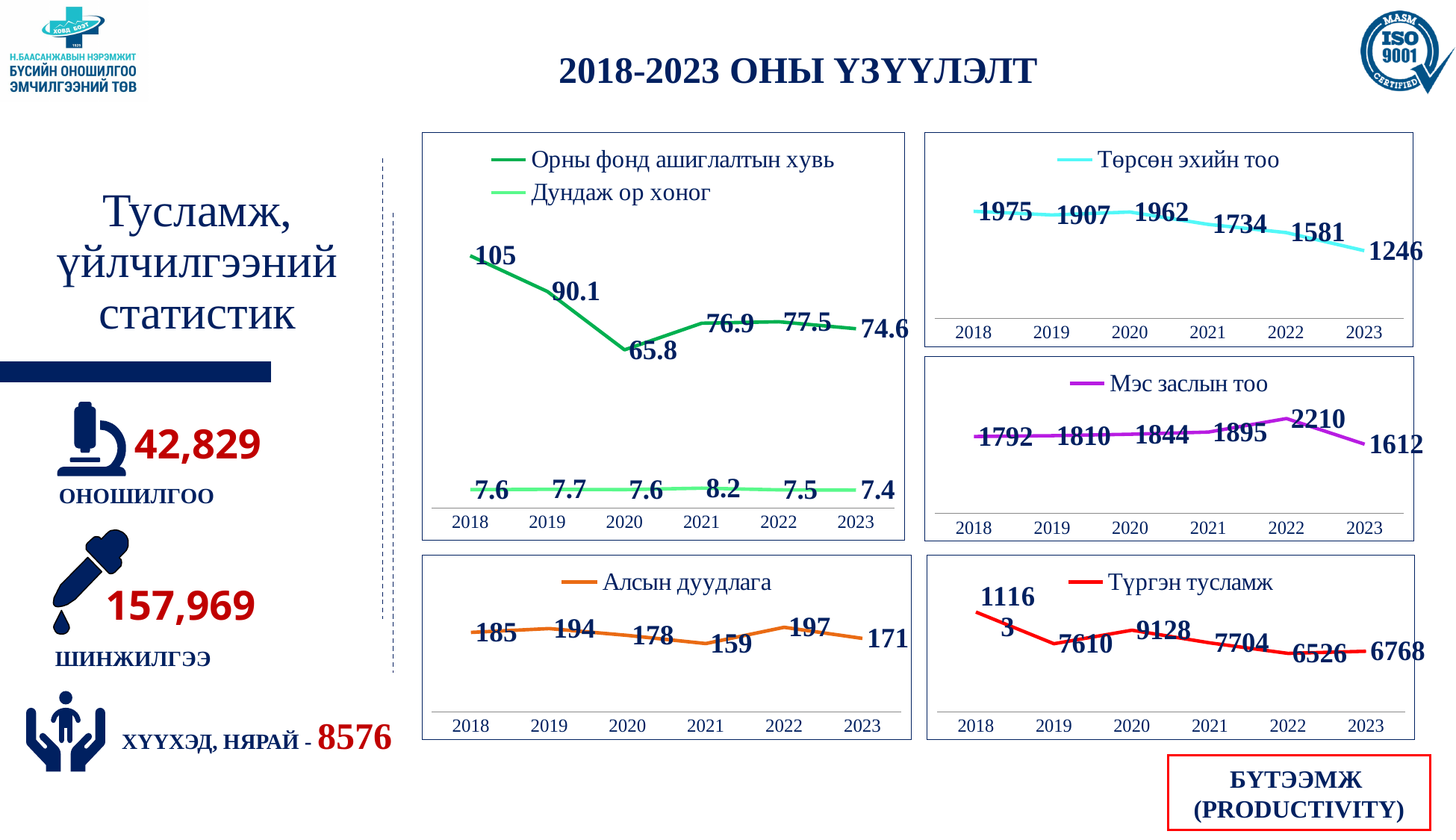
What kind of chart is the chart with the legend 'Алсын дуудлага' (bottom left)? line chart In the top-left chart, what is the value of 'Дундаж ор хоног' for 2021? 8.2 How many series does the legend of the top-left chart list? 2 In the top-left chart, what is the value of 'Орны фонд ашиглалтын хувь' for 2020? 65.8 In the chart with the legend 'Мэс заслын тоо' (middle right), what is the value for 2022? 2210 In the chart with the legend 'Төрсөн эхийн тоо' (top right), do the values generally rise or fall from 2018 to 2023? fall In the chart with the legend 'Төрсөн эхийн тоо' (top right), what is the value for 2023? 1246 In the chart with the legend 'Алсын дуудлага' (bottom left), which year has the lowest value? 2021 In the chart with the legend 'Түргэн тусламж' (bottom right), what is the value for 2020? 9128 In the chart with the legend 'Мэс заслын тоо' (middle right), which year has the highest value? 2022 In the chart with the legend 'Алсын дуудлага' (bottom left), what is the difference between the 2022 value and the 2021 value? 38 In the chart with the legend 'Түргэн тусламж' (bottom right), which is larger, the value for 2019 or the value for 2021? 2021